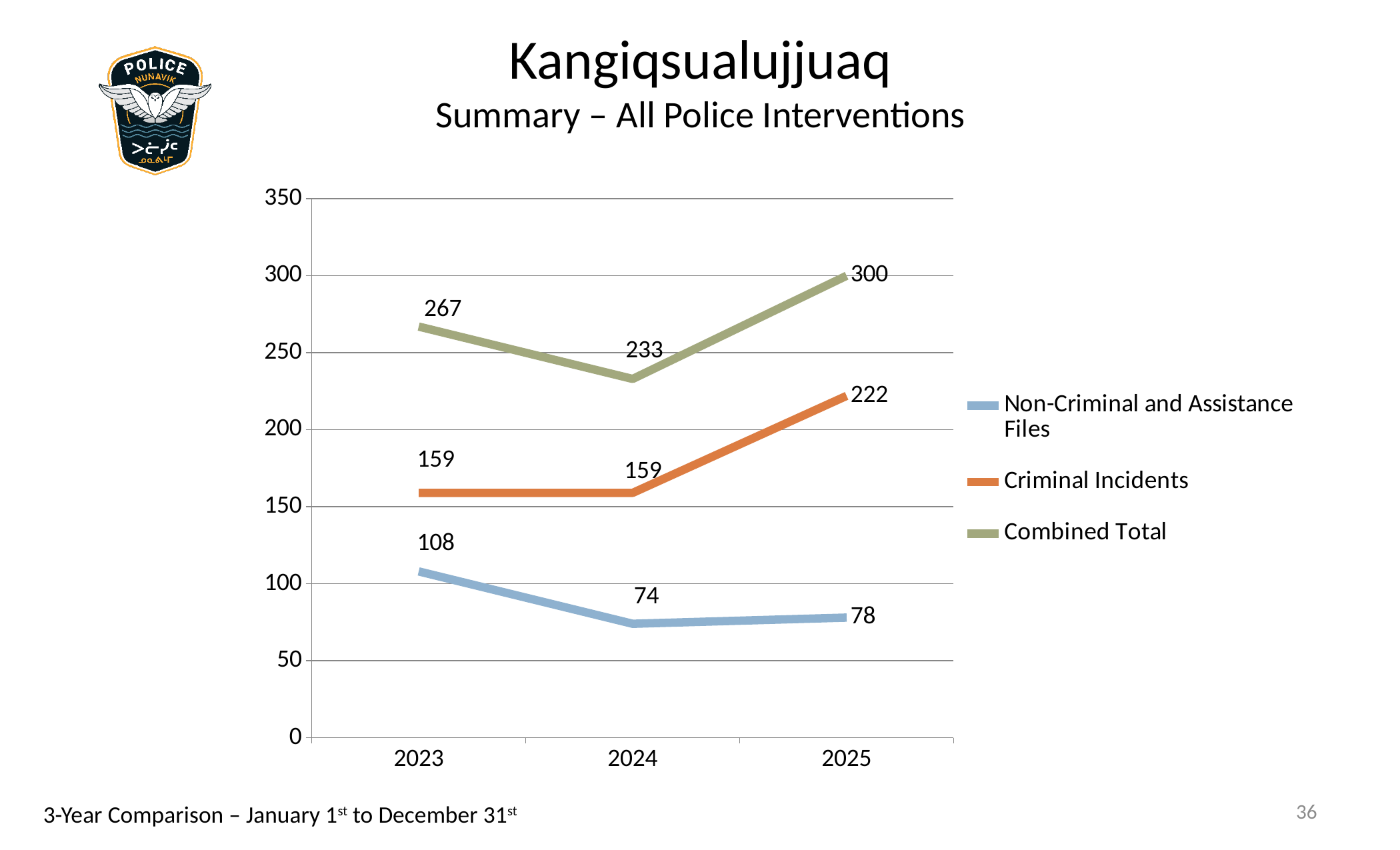
What is the value for Non-Criminal and Assistance Files in 2023? 108 What is the difference between the Combined Total in 2025 and in 2024? 67 What is the difference between Criminal Incidents in 2025 and in 2024? 63 How many series does the legend list? 3 How many years are shown on the x axis? 3 Which is larger: Non-Criminal and Assistance Files in 2023 or in 2025? 2023 What kind of chart is shown on the slide? line chart What is the value for Criminal Incidents in 2025? 222 In which year is the value for Non-Criminal and Assistance Files lowest? 2024 In which year is the Combined Total highest? 2025 Does the Criminal Incidents series rise or fall from 2024 to 2025? rise What is the Combined Total for 2024? 233